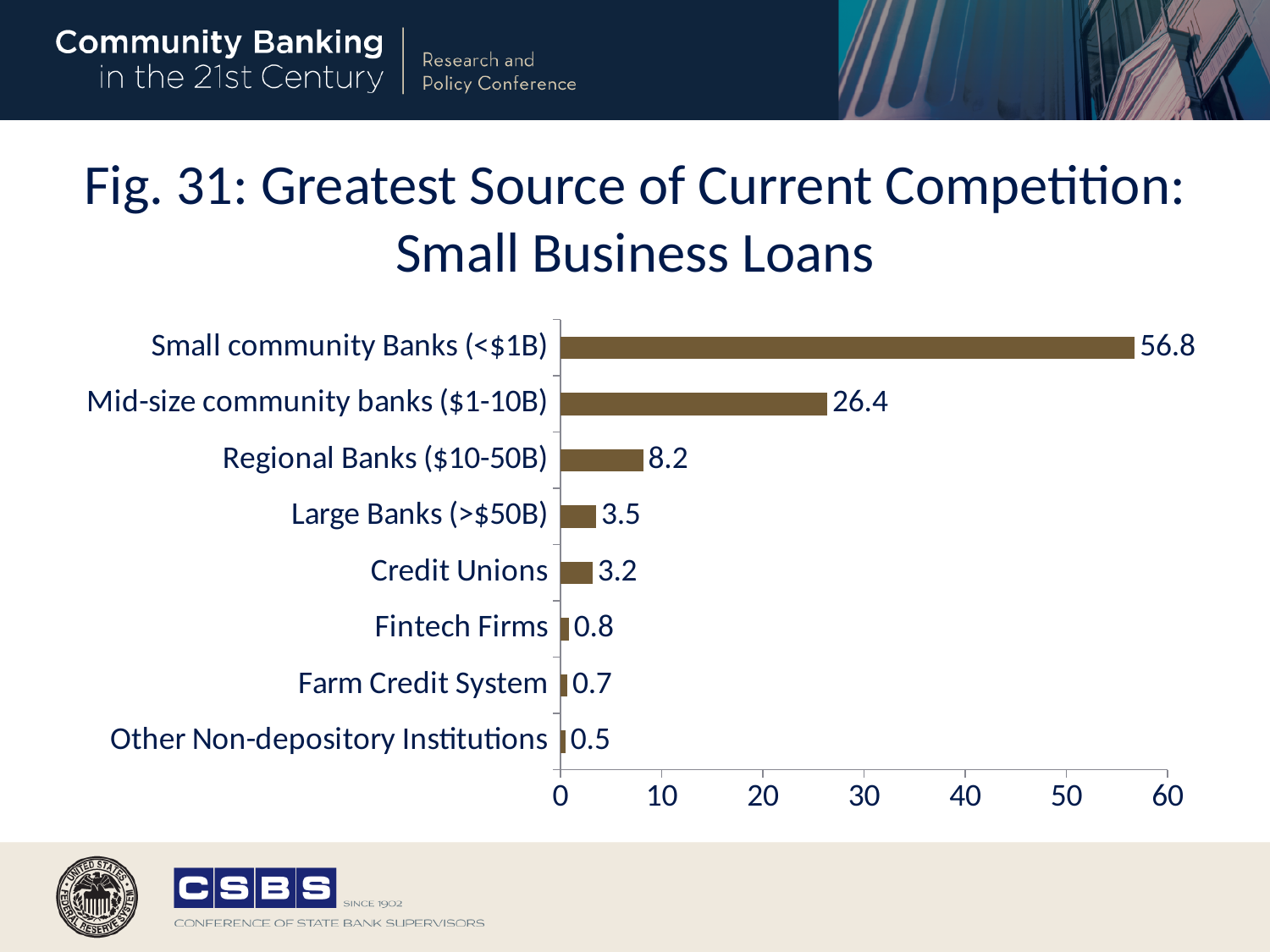
How many categories are shown in the chart? 8 What is the value for Small community Banks (<$1B)? 56.8 What kind of chart is shown on the slide? bar chart What is the value for Regional Banks ($10-50B)? 8.2 What is the title of the chart? Fig. 31: Greatest Source of Current Competition: Small Business Loans Which category has the highest value? Small community Banks (<$1B) What is the value for Farm Credit System? 0.7 What is the value for Credit Unions? 3.2 Which is larger, the value for Large Banks (>$50B) or the value for Credit Unions? Large Banks (>$50B) Is the value for Mid-size community banks ($1-10B) greater or less than 20? greater Which category has the lowest value? Other Non-depository Institutions What is the difference between the values for Small community Banks (<$1B) and Mid-size community banks ($1-10B)? 30.4